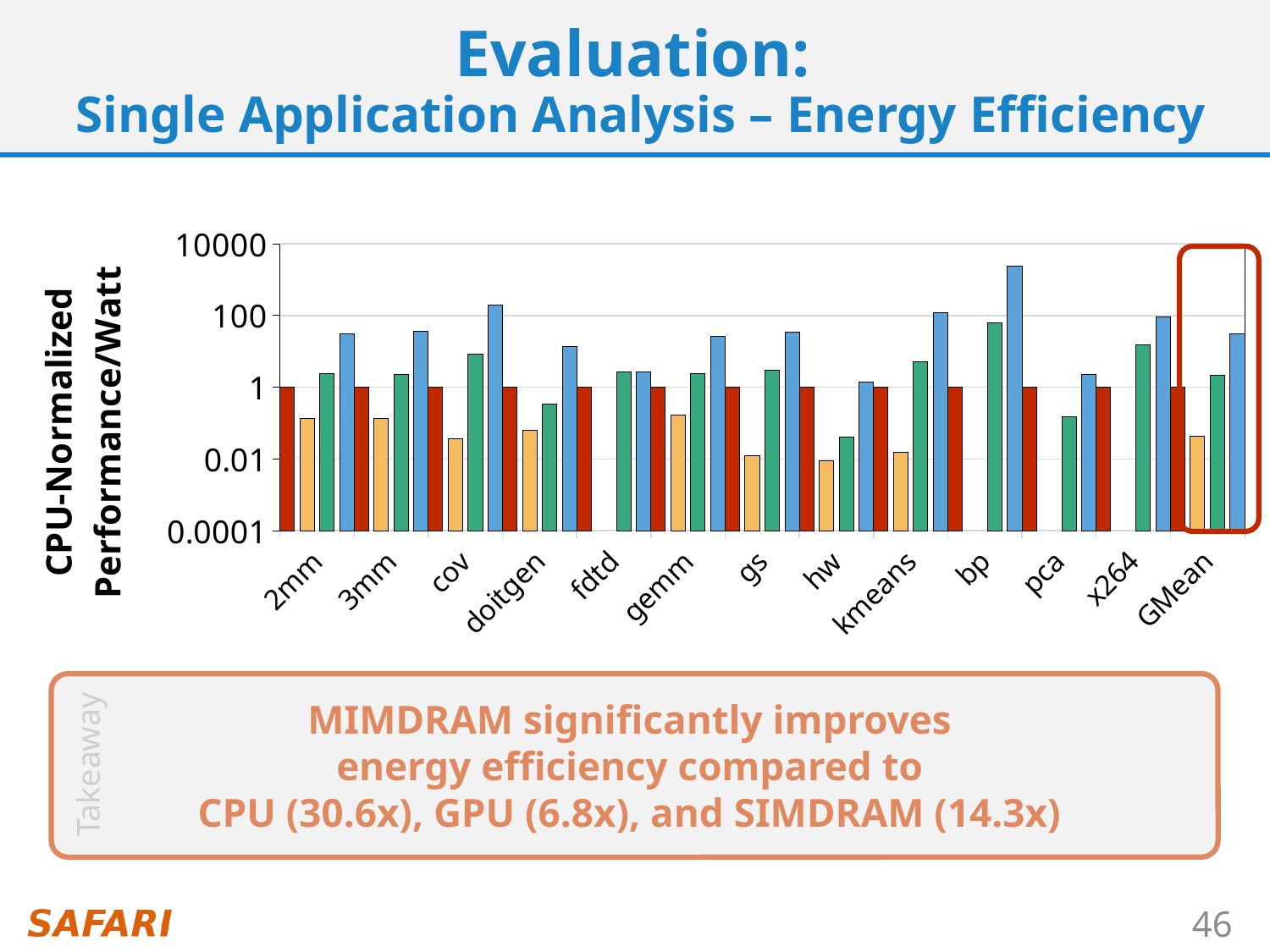
Is the yellow bar for 2mm greater or less than 1? less Which is larger, the blue bar for bp or the blue bar for 2mm? bp Which category has the tallest green bar? bp Is the blue bar for bp greater or less than 100? greater Is the blue bar for doitgen greater or less than 100? less What value does the red bar for GMean land on? 1 What is the y-axis title of the chart? CPU-Normalized Performance/Watt How many application categories are shown on the x axis of the chart? 13 Which category has the tallest blue bar? bp Which category on the x axis is highlighted with a red box? GMean What value does the red bar for 2mm land on? 1 What kind of chart is shown on the slide? bar chart